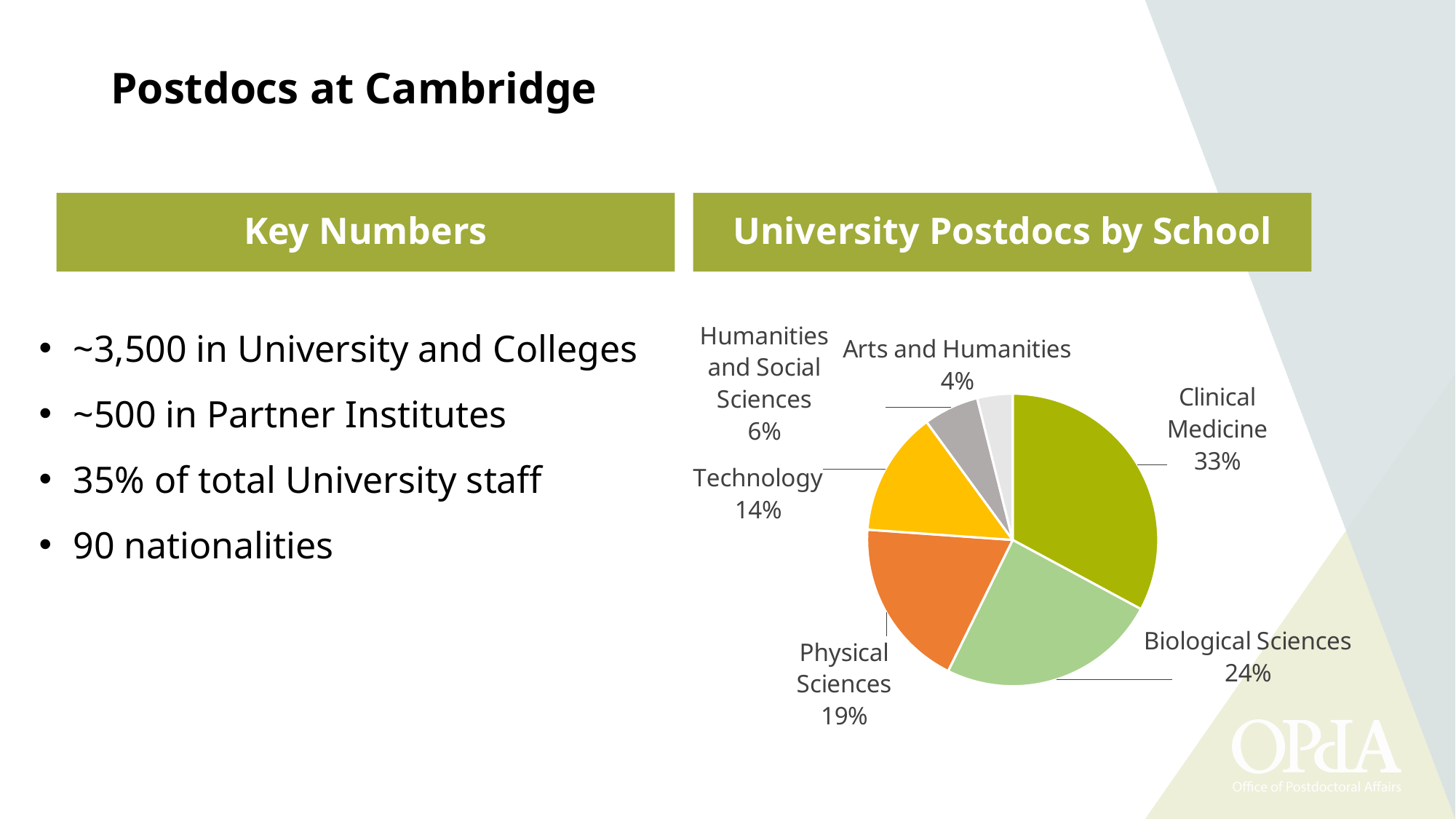
Which school has the smallest share of University postdocs? Arts and Humanities What is the title of the pie chart? University Postdocs by School What share of University postdocs is in Physical Sciences? 19% What is the difference in percentage points between Clinical Medicine and Biological Sciences? 9 What kind of chart is shown under 'University Postdocs by School'? pie chart Which school has the largest share of University postdocs? Clinical Medicine What share of University postdocs is in Clinical Medicine? 33% How many schools are shown in the pie chart? 6 What share of University postdocs is in Technology? 14% Which has a larger share of University postdocs, Technology or Physical Sciences? Physical Sciences